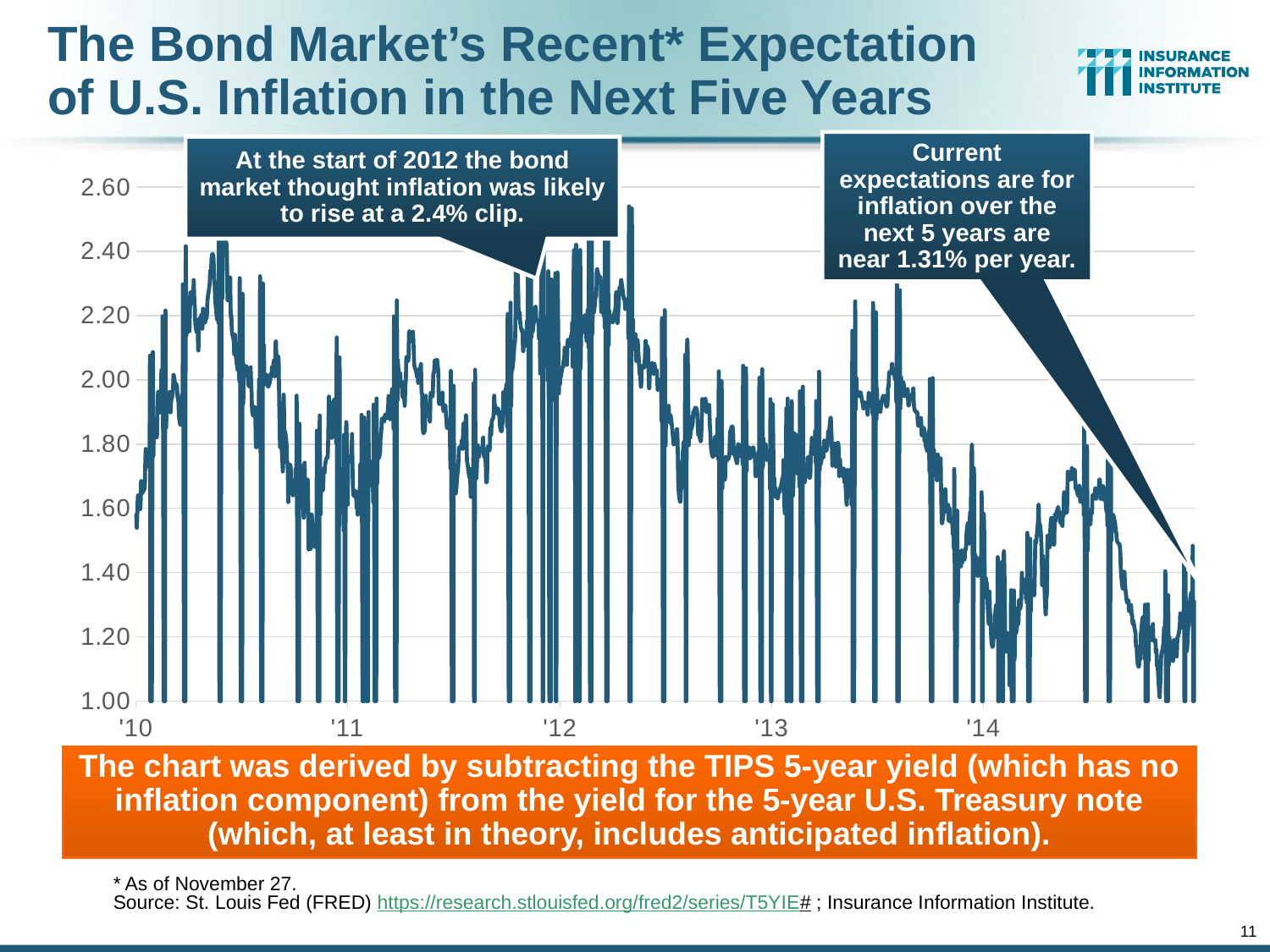
Does the line generally rise or fall from the start of 2012 to the end of 2014? fall According to the callout, what are current expectations for inflation over the next 5 years? near 1.31% per year Is the value at the start of 2010 greater or less than 2.00? less What is the title of the chart? The Bond Market's Recent* Expectation of U.S. Inflation in the Next Five Years Which is larger: the expected inflation at the start of 2012 or at the end of 2014? start of 2012 Is the value at the start of 2012 greater or less than 2.20? greater According to the callout, what inflation rate did the bond market expect at the start of 2012? 2.4% What is the highest value shown on the y axis? 2.60 Is the value at the end of 2014 greater or less than 1.60? less What kind of chart is shown on the slide? line chart How many year labels are shown on the x axis? 5